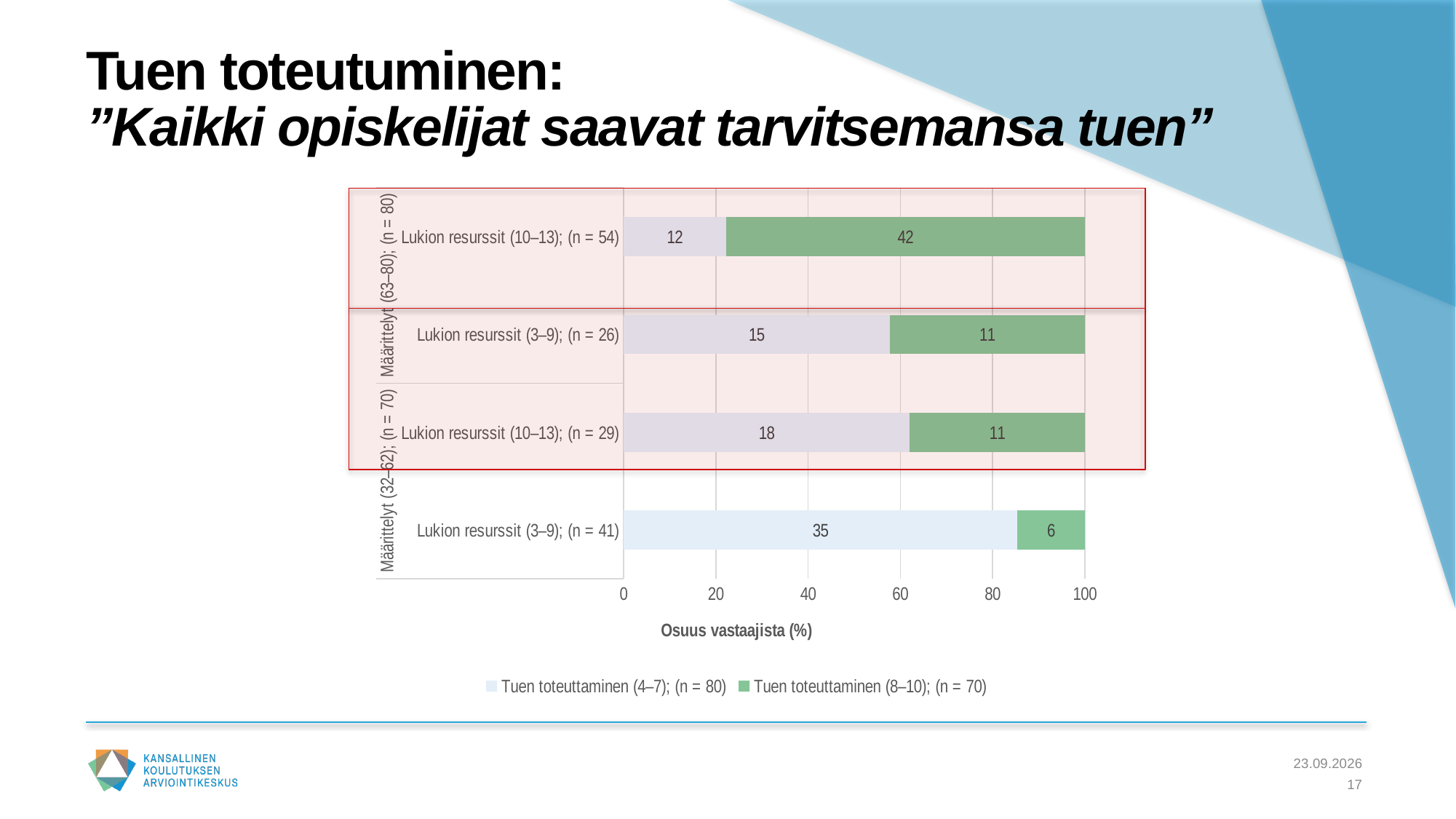
What is the difference between the 'Tuen toteuttaminen (8–10)' value and the 'Tuen toteuttaminen (4–7)' value in the bar 'Lukion resurssit (10–13); (n = 54)'? 30 What is the total of the two data labels in the bar 'Lukion resurssit (10–13); (n = 29)'? 29 What is the title of the horizontal axis? Osuus vastaajista (%) What is the data label for 'Tuen toteuttaminen (4–7)' in the bar 'Lukion resurssit (10–13); (n = 29)'? 18 Which bar has the lowest 'Tuen toteuttaminen (8–10)' value? Lukion resurssit (3–9); (n = 41) What is the data label for 'Tuen toteuttaminen (4–7)' in the bar 'Lukion resurssit (3–9); (n = 41)'? 35 What type of chart is shown on the slide? stacked bar chart How many series does the legend list? 2 How many bars (categories) are plotted in the chart? 4 What is the data label for 'Tuen toteuttaminen (8–10)' in the bar 'Lukion resurssit (10–13); (n = 54)'? 42 What is the data label for 'Tuen toteuttaminen (8–10)' in the bar 'Lukion resurssit (3–9); (n = 26)'? 11 Which bar has the highest 'Tuen toteuttaminen (8–10)' value? Lukion resurssit (10–13); (n = 54)